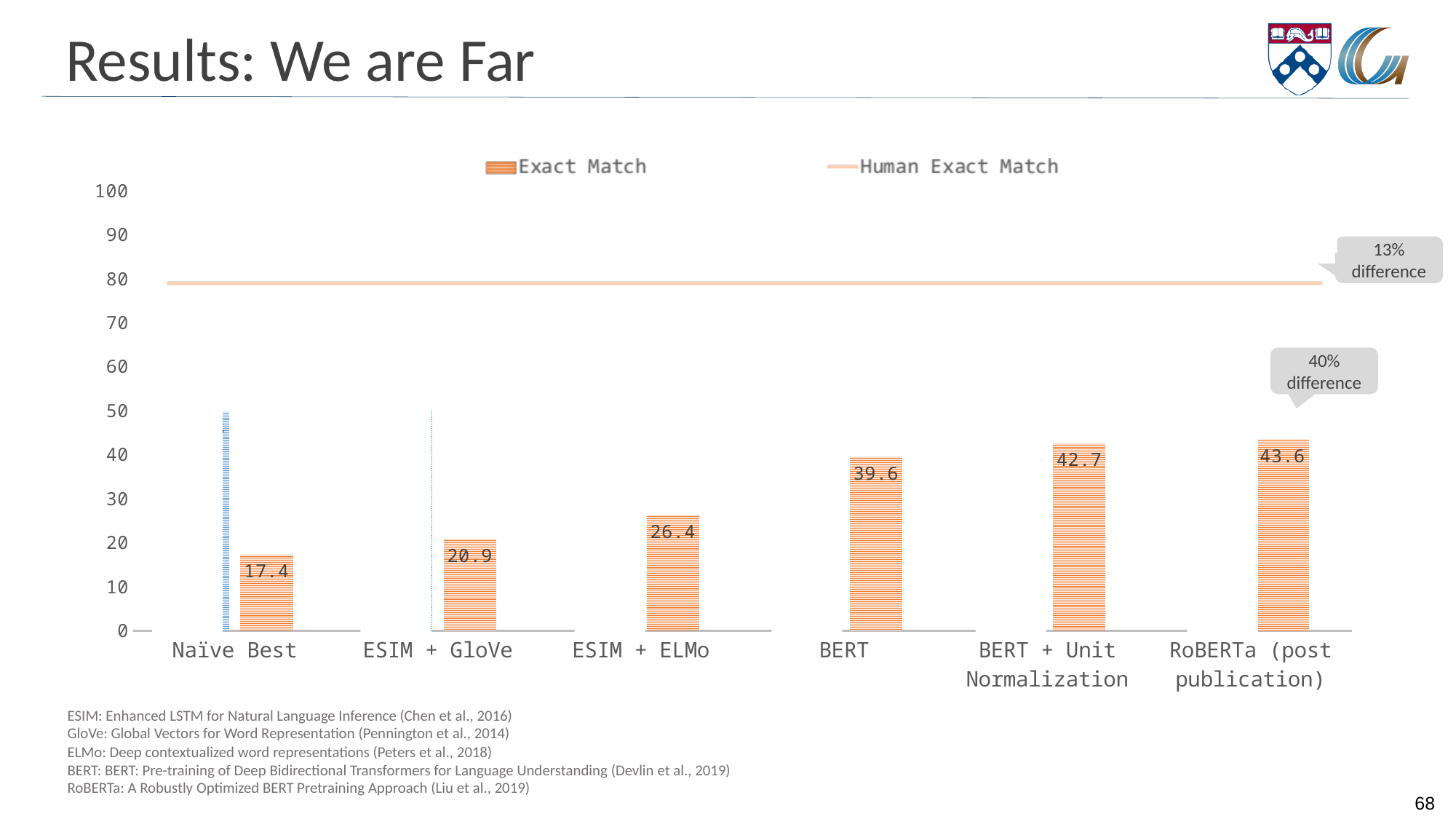
What is the Exact Match value for BERT? 39.6 Is the Human Exact Match line greater or less than 70? greater Which category has the lowest Exact Match value? Naïve Best Which has a higher Exact Match value, ESIM + ELMo or BERT? BERT Which category has the highest Exact Match value? RoBERTa (post publication) What is the Exact Match value for ESIM + ELMo? 26.4 What kind of chart is shown on the slide? Bar chart How many categories are shown on the x axis? 6 What is the Exact Match value for Naïve Best? 17.4 What is the difference between the Exact Match values for BERT + Unit Normalization and ESIM + GloVe? 21.8 How many series does the legend list? 2 Do the Exact Match values rise or fall from left to right along the x axis? Rise